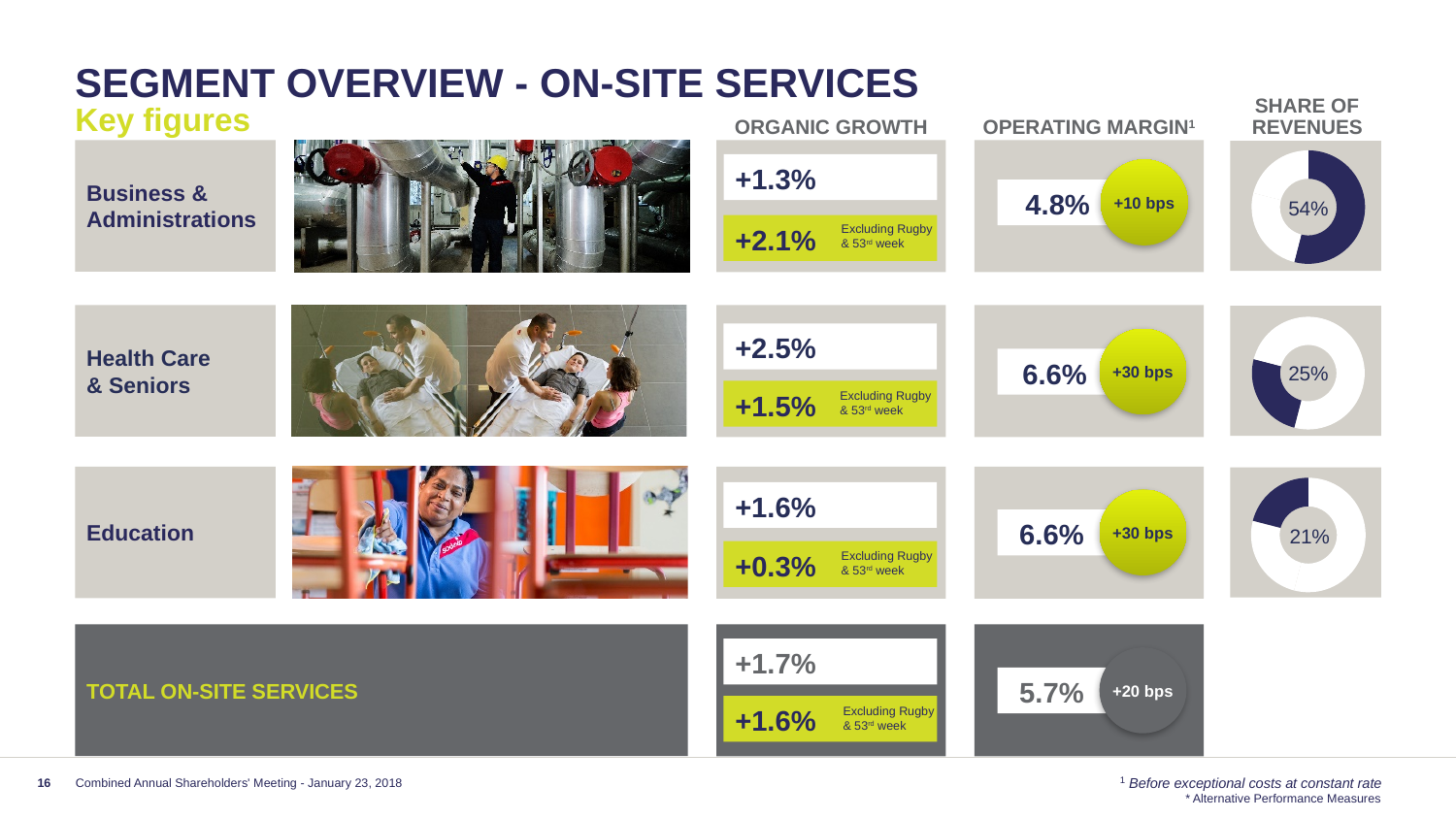
In the Share of Revenues donut chart for Health Care & Seniors, what share is shown? 25% How many Share of Revenues donut charts are shown on the slide? 3 What is the difference between the Share of Revenues for Business & Administrations and for Education? 33 percentage points What type of chart is used to show Share of Revenues on the slide? Donut (pie) chart Among the three Share of Revenues donut charts, which segment has the largest share? Business & Administrations What is the title of the column containing the donut charts? SHARE OF REVENUES In the Share of Revenues donut chart for Education, what share is shown? 21% Which is larger: the Share of Revenues for Health Care & Seniors or for Education? Health Care & Seniors What is the combined Share of Revenues shown for Health Care & Seniors and Education? 46% Among the three Share of Revenues donut charts, which segment has the smallest share? Education What colour is the filled segment in the Share of Revenues donut charts? Dark navy blue In the Share of Revenues donut chart for Business & Administrations, what share is shown? 54%